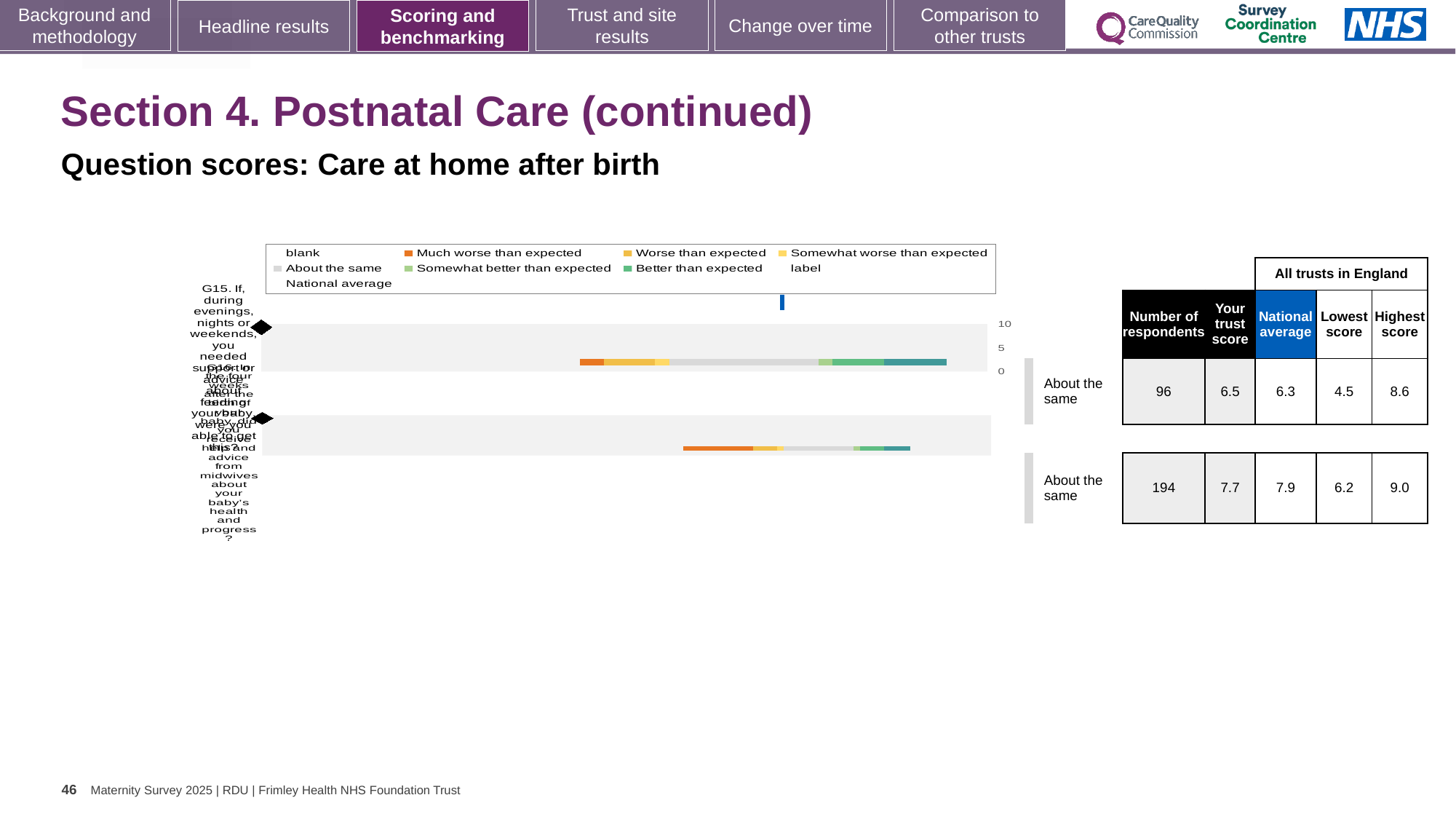
In the table next to the chart, what is the trust score for the first row? 6.5 In the table next to the chart, what is the highest score for the second row? 9.0 What is the title of the slide section above the chart? Question scores: Care at home after birth What kind of chart is shown on the slide? bar chart In the table next to the chart, what is the national average for the second row? 7.9 How many question rows (bars) does the chart show? 2 Which row has more respondents, the first or the second? the second Which legend entry is shown in dark orange? Much worse than expected What is the difference in number of respondents between the second row and the first row? 98 In the table next to the chart, what is the lowest score for the first row? 4.5 In the table next to the chart, what is the number of respondents for the first row? 96 In the table next to the chart, what is the number of respondents for the second row? 194